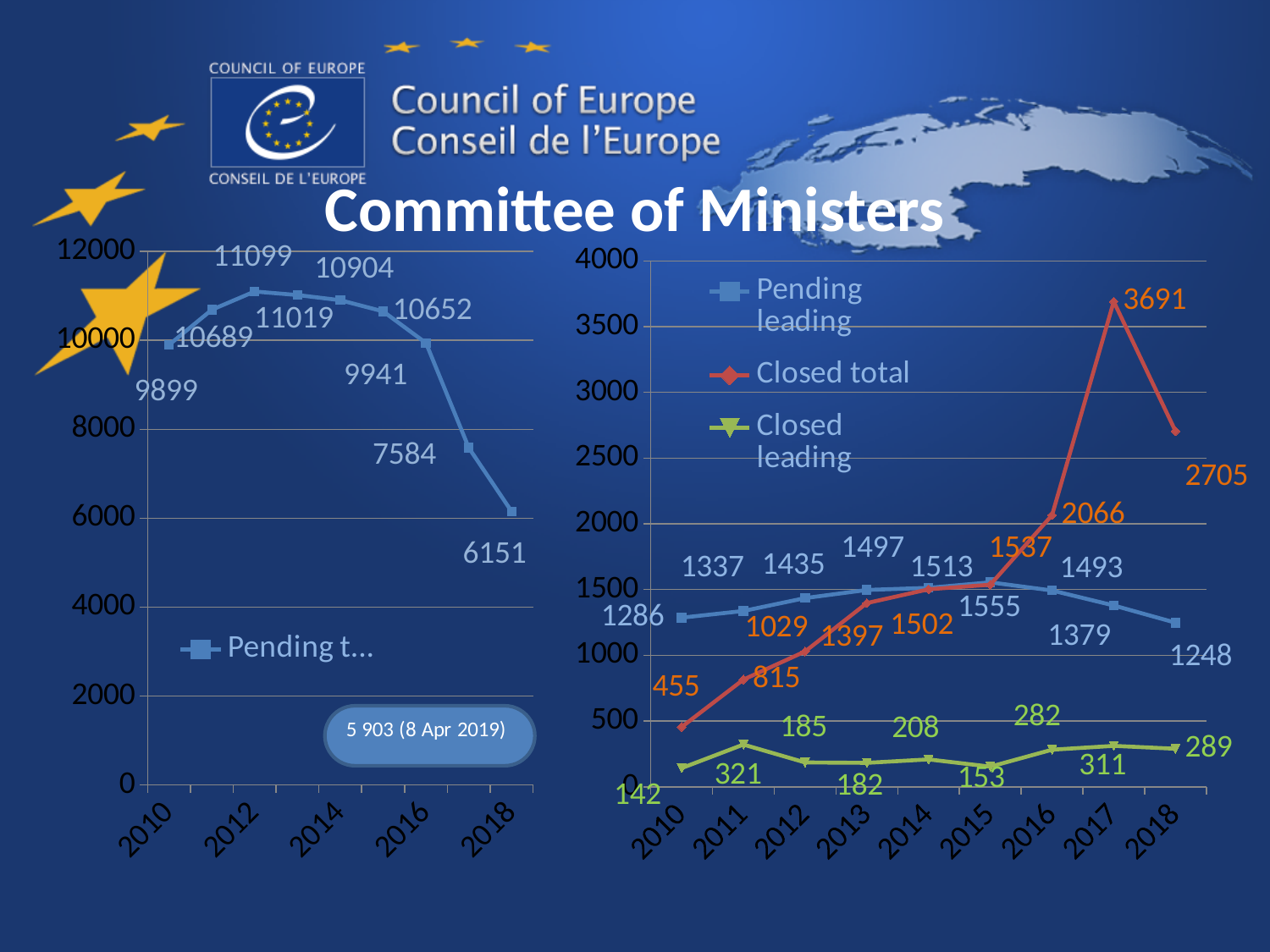
What kind of chart is the right chart? Line chart In the left chart, which year has the lowest value? 2018 In the right chart, what is the Closed total value for 2017? 3691 In the right chart, which is larger in 2018: Closed total or Pending leading? Closed total In the left chart, which year has the highest value? 2012 In the left chart, what is the value for 2018? 6151 In the left chart, what is the value for 2012? 11099 In the right chart, what is the Closed leading value for 2010? 142 How many series does the legend of the right chart list? 3 In the right chart, does the Closed total series rise or fall from 2010 to 2017? Rise In the right chart, which year has the highest Closed total value? 2017 In the left chart, what is the difference between the 2017 value and the 2018 value? 1433